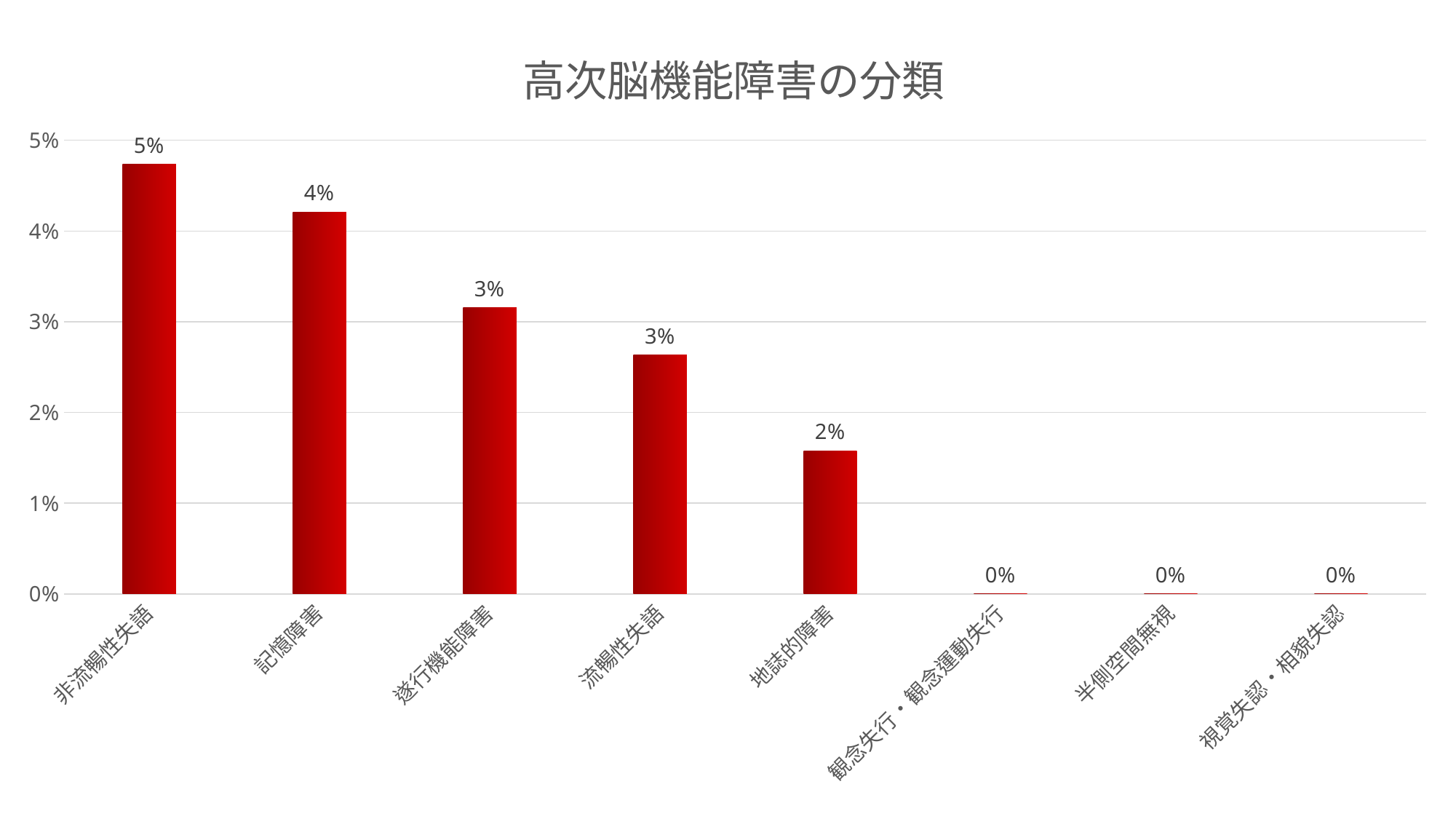
What is the value shown for 記憶障害? 4% Is the value for 流暢性失語 greater or less than 3% on the axis? less How many categories have a value labelled 0%? 3 What type of chart is shown on the slide? Bar chart What is the value shown for 半側空間無視? 0% What is the value shown for 非流暢性失語? 5% What is the value shown for 地誌的障害? 2% Do the values rise or fall from left to right along the x axis? Fall What is the title of the chart? 高次脳機能障害の分類 Which bar is taller, 遂行機能障害 or 流暢性失語? 遂行機能障害 Which category has the highest value? 非流暢性失語 How many categories are shown on the x axis? 8